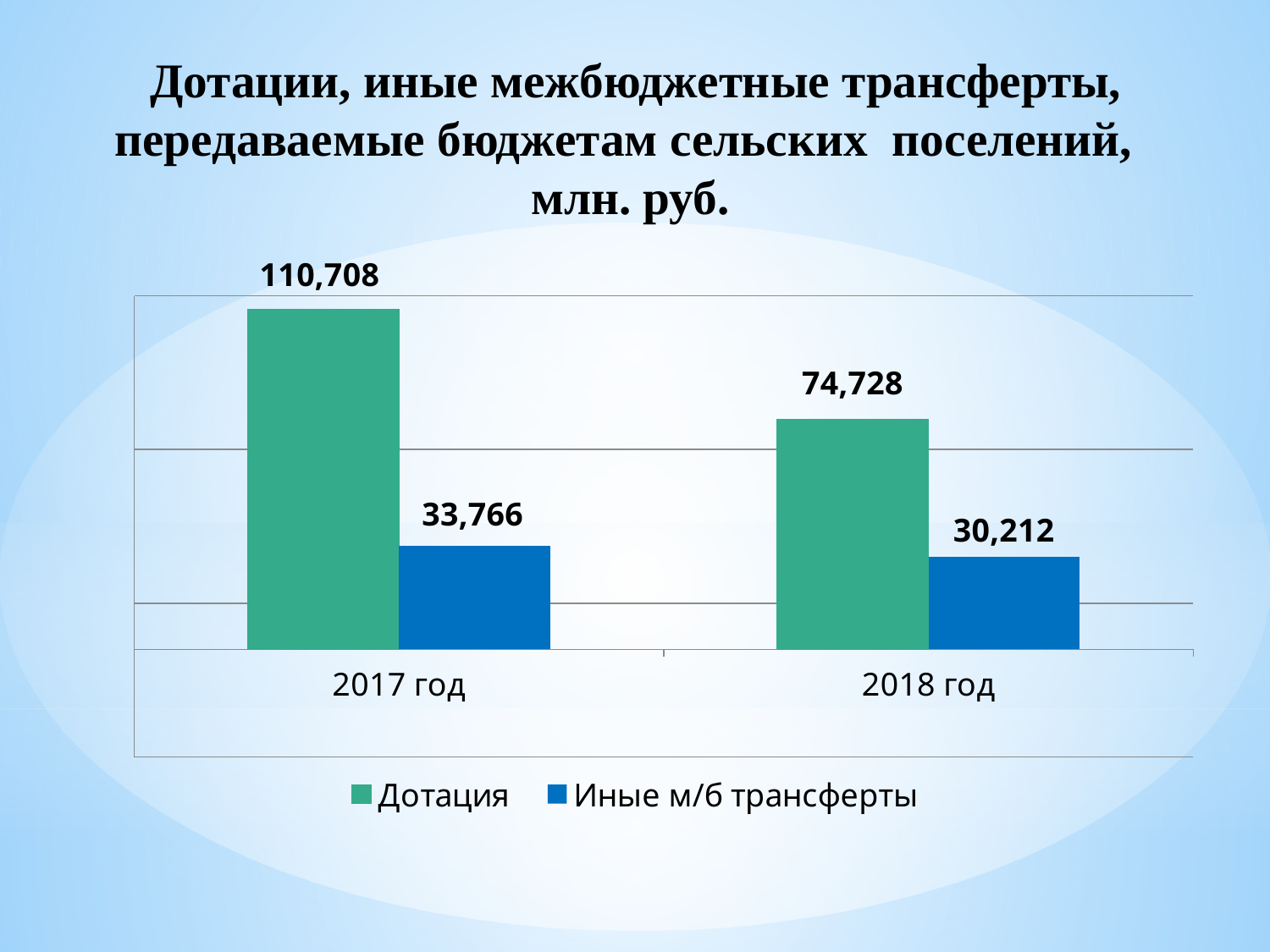
What is the difference between the Дотация values for 2017 год and 2018 год? 35,980 What is the value of Дотация for 2018 год? 74,728 What is the value of Иные м/б трансферты for 2017 год? 33,766 Which bar has the lowest value on the chart? Иные м/б трансферты for 2018 год Do the Дотация values rise or fall from 2017 год to 2018 год? Fall Which year has the highest Дотация value? 2017 год Which is larger in 2018 год: Дотация or Иные м/б трансферты? Дотация How many series does the legend list? 2 What is the difference between the Иные м/б трансферты values for 2017 год and 2018 год? 3,554 What kind of chart is shown on the slide? Bar chart What is the value of Дотация for 2017 год? 110,708 What is the value of Иные м/б трансферты for 2018 год? 30,212